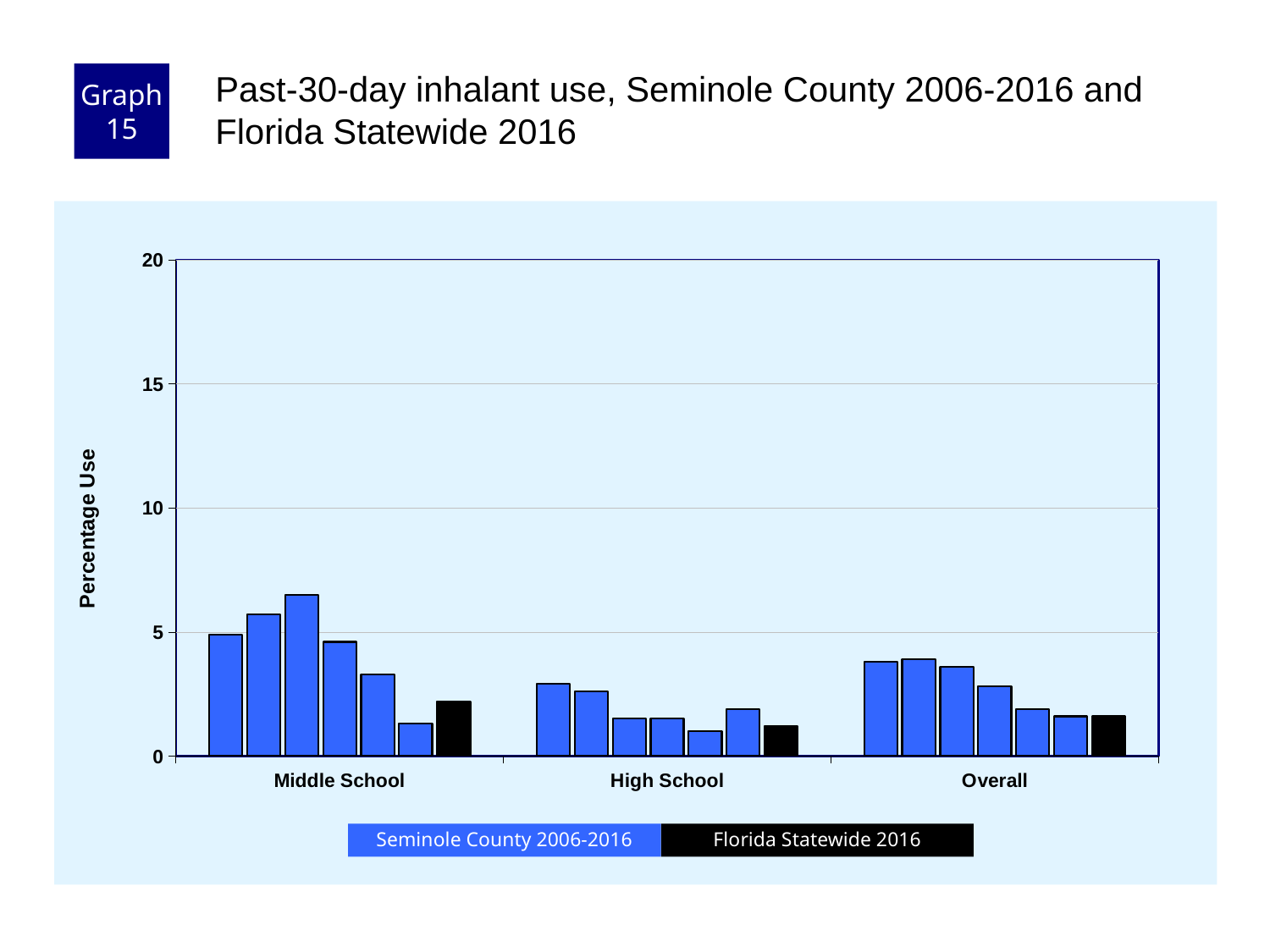
Is the Florida Statewide 2016 value for High School greater or less than 5? less How many categories are shown on the x axis? 3 Which category contains the tallest bar in the chart? Middle School Which is larger, the Florida Statewide 2016 bar for Middle School or the Florida Statewide 2016 bar for High School? Middle School Is the Florida Statewide 2016 value for Overall greater or less than 5? less What is the label of the y axis? Percentage Use Within the Overall group, do the Seminole County bars generally rise or fall from left to right? fall What kind of chart is shown on the slide? bar chart How many series does the legend list? 2 What colour are the Florida Statewide 2016 bars? black Which category has the lowest Florida Statewide 2016 bar? High School Is the tallest Seminole County bar in the Middle School group greater or less than 5? greater